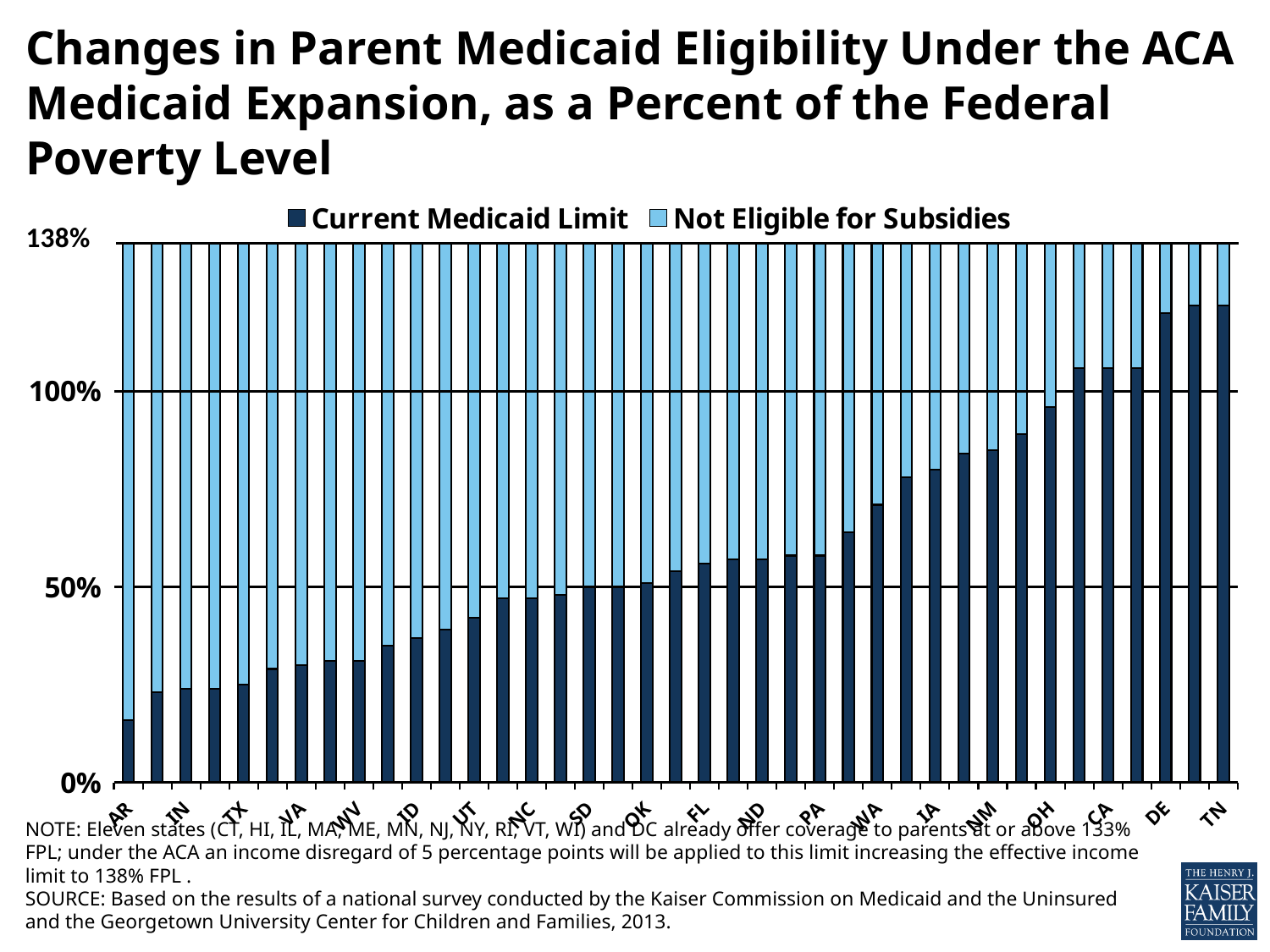
What are the two series named in the legend? Current Medicaid Limit; Not Eligible for Subsidies Is the Current Medicaid Limit for UT greater or less than 50%? less What kind of chart is shown on the slide? Stacked bar chart Is the Current Medicaid Limit for CA greater or less than 100%? greater Is the Current Medicaid Limit for TN greater or less than 100%? greater How many series does the legend list? 2 Which state has the lowest Current Medicaid Limit? AR Do the Current Medicaid Limit values rise or fall moving from left to right along the x axis? Rise Which state has the larger Current Medicaid Limit, VA or WA? WA What is the total height of each stacked bar, as shown by the top axis tick? 138%